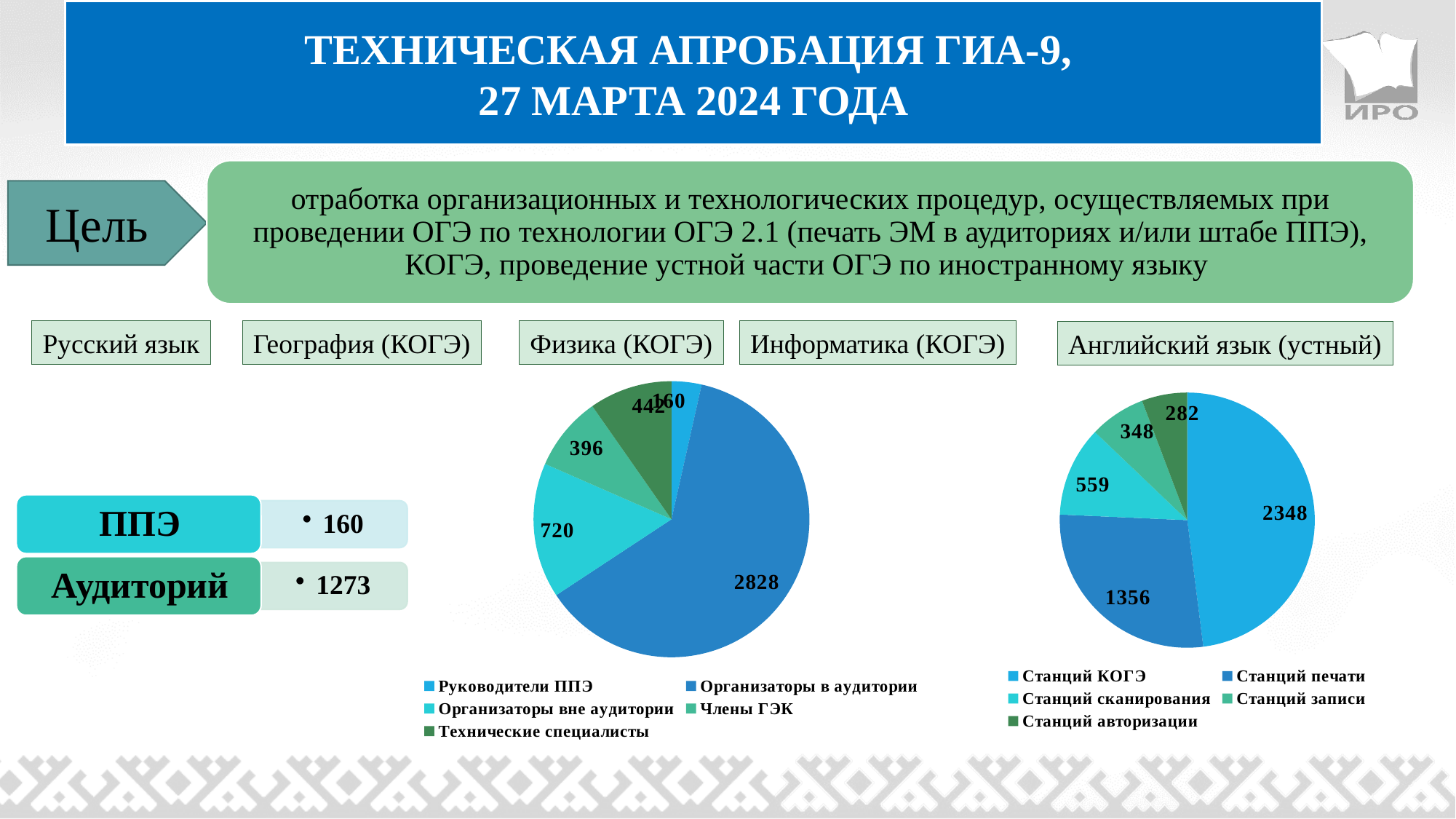
In the right pie chart, what is the value for Станций записи? 348 How many categories does the legend of the left pie chart list? 5 In the left pie chart, which category has the smallest value? Руководители ППЭ In the right pie chart, what is the total of all slices? 4893 In the right pie chart, which category has the largest value? Станций КОГЭ What type of chart is the left chart on the slide? pie chart In the right pie chart, what is the difference between Станций КОГЭ and Станций печати? 992 In the right pie chart, what is the value for Станций печати? 1356 In the left pie chart, what is the value for Члены ГЭК? 396 In the right pie chart, which is larger: Станций сканирования or Станций авторизации? Станций сканирования In the left pie chart, what is the difference between Организаторы в аудитории and Организаторы вне аудитории? 2108 In the left pie chart, what is the value for Организаторы в аудитории? 2828